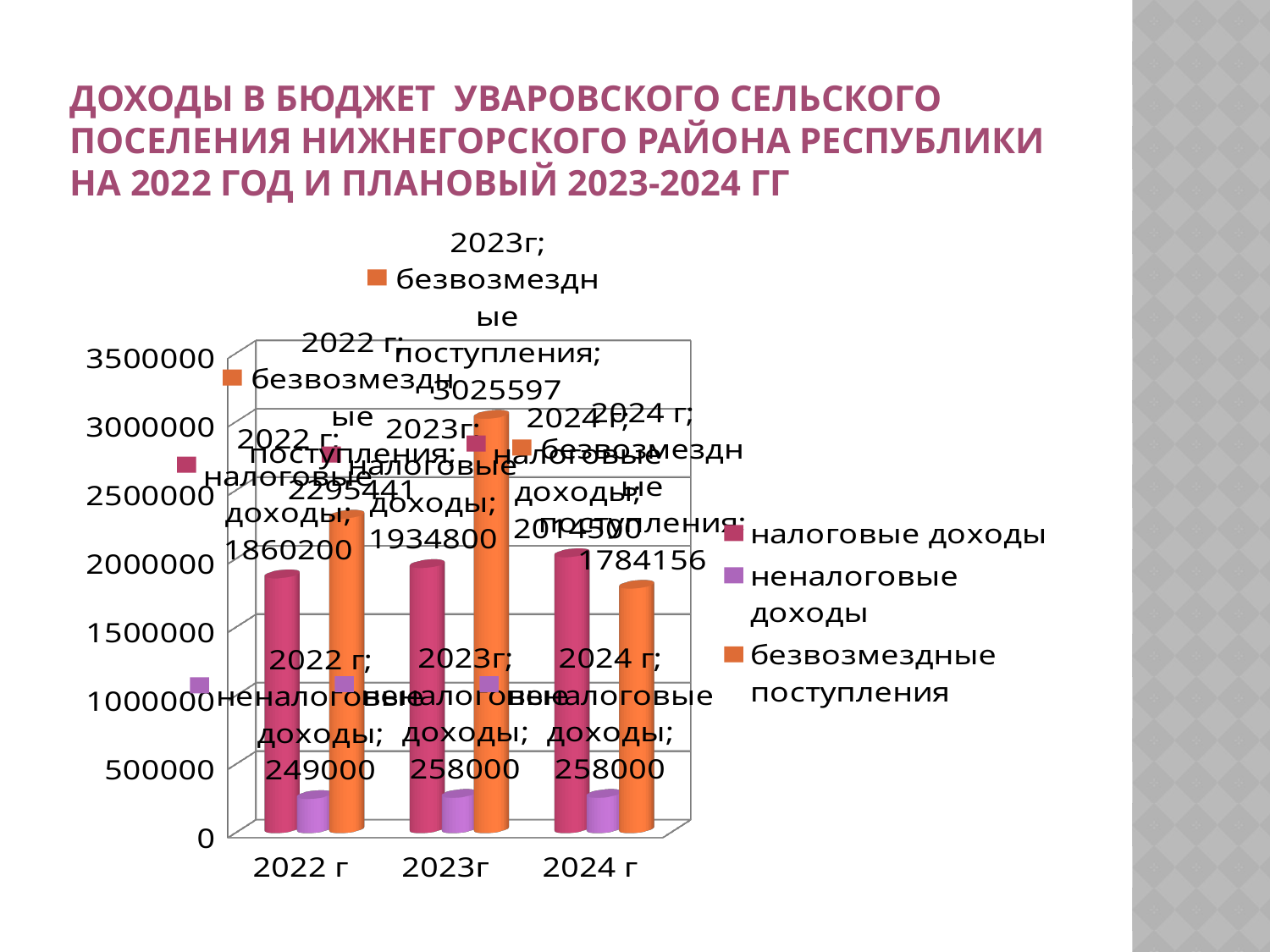
What is the value of неналоговые доходы for 2022 г? 249000 In which year are неналоговые доходы the lowest? 2022 г How many years (categories) are shown on the x axis? 3 What is the value of безвозмездные поступления for 2024 г? 1784156 By how much do налоговые доходы in 2023г exceed those in 2022 г? 74600 What is the difference between безвозмездные поступления in 2023г and in 2024 г? 1241441 In which year are безвозмездные поступления the highest? 2023г Do налоговые доходы rise or fall from 2022 г to 2024 г? rise How many series does the legend list? 3 What is the value of налоговые доходы for 2022 г? 1860200 In 2022 г, which is larger: налоговые доходы or безвозмездные поступления? безвозмездные поступления What is the value of безвозмездные поступления for 2023г? 3025597